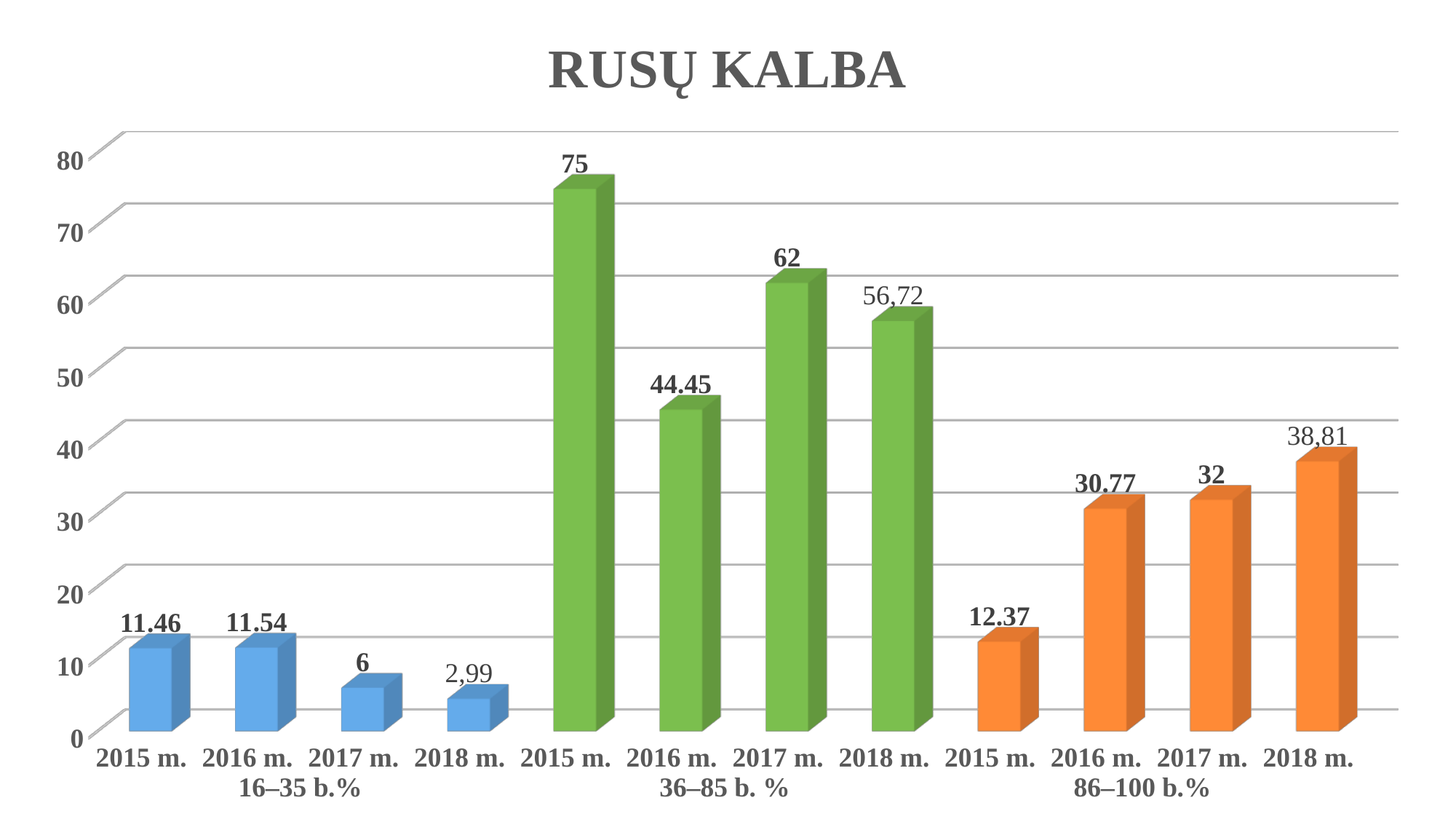
Which bar has the lowest value on the chart? 2018 m. in the 16–35 b.% group (2,99) Which is larger: the 2017 m. value in the 86–100 b.% group or the 2016 m. value in the 86–100 b.% group? 2017 m. (32) Is the value for 2018 m. in the 86–100 b.% group greater or less than 40? less What is the value for 2016 m. in the 86–100 b.% group? 30.77 What kind of chart is shown on the slide? bar chart How many bars are plotted on the chart? 12 What is the value for 2018 m. in the 36–85 b. % group? 56,72 What is the value for 2018 m. in the 16–35 b.% group? 2,99 Do the values in the 86–100 b.% group rise or fall from 2015 m. to 2018 m.? rise Which bar has the highest value on the chart? 2015 m. in the 36–85 b. % group (75) What is the value for 2015 m. in the 36–85 b. % group? 75 What is the difference between the 2017 m. and 2016 m. values in the 36–85 b. % group? 17.55